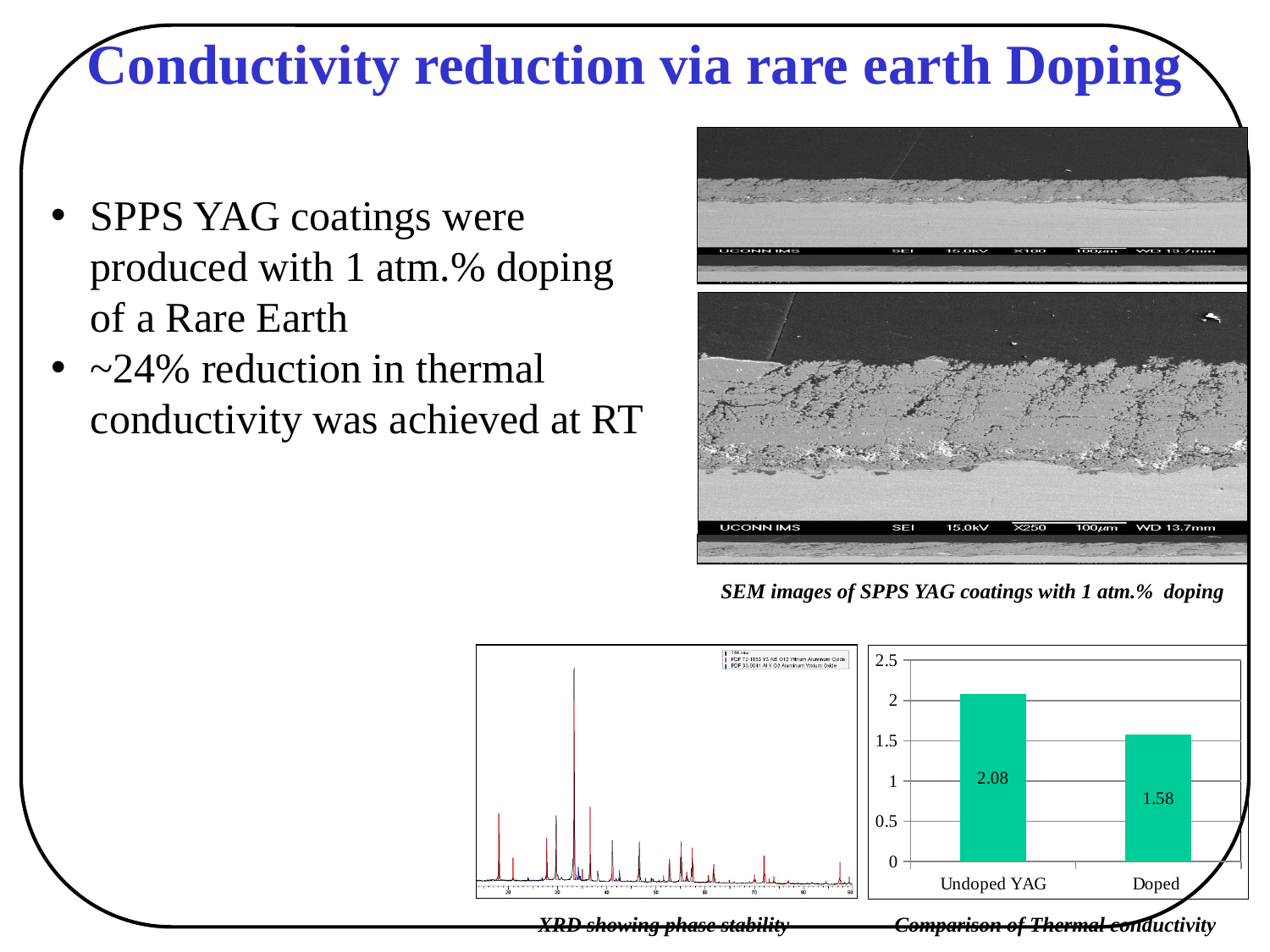
In the bar chart at the bottom right, what is the difference between the Undoped YAG and Doped values? 0.5 How many categories are shown in the bar chart at the bottom right? 2 In the bar chart at the bottom right, which category has the lowest value? Doped What kind of chart is shown at the bottom right of the slide? bar chart In the bar chart at the bottom right, what is the value for Doped? 1.58 In the bar chart at the bottom right, is the value for Undoped YAG greater or less than 1.5? greater In the bar chart at the bottom right, what is the value for Undoped YAG? 2.08 What is the maximum value shown on the vertical axis of the bar chart at the bottom right? 2.5 What caption appears below the bar chart at the bottom right? Comparison of Thermal conductivity In the bar chart at the bottom right, is the value for Doped greater or less than 2? less In the bar chart at the bottom right, which category has the highest value? Undoped YAG In the bar chart at the bottom right, which is larger, the value for Undoped YAG or the value for Doped? Undoped YAG